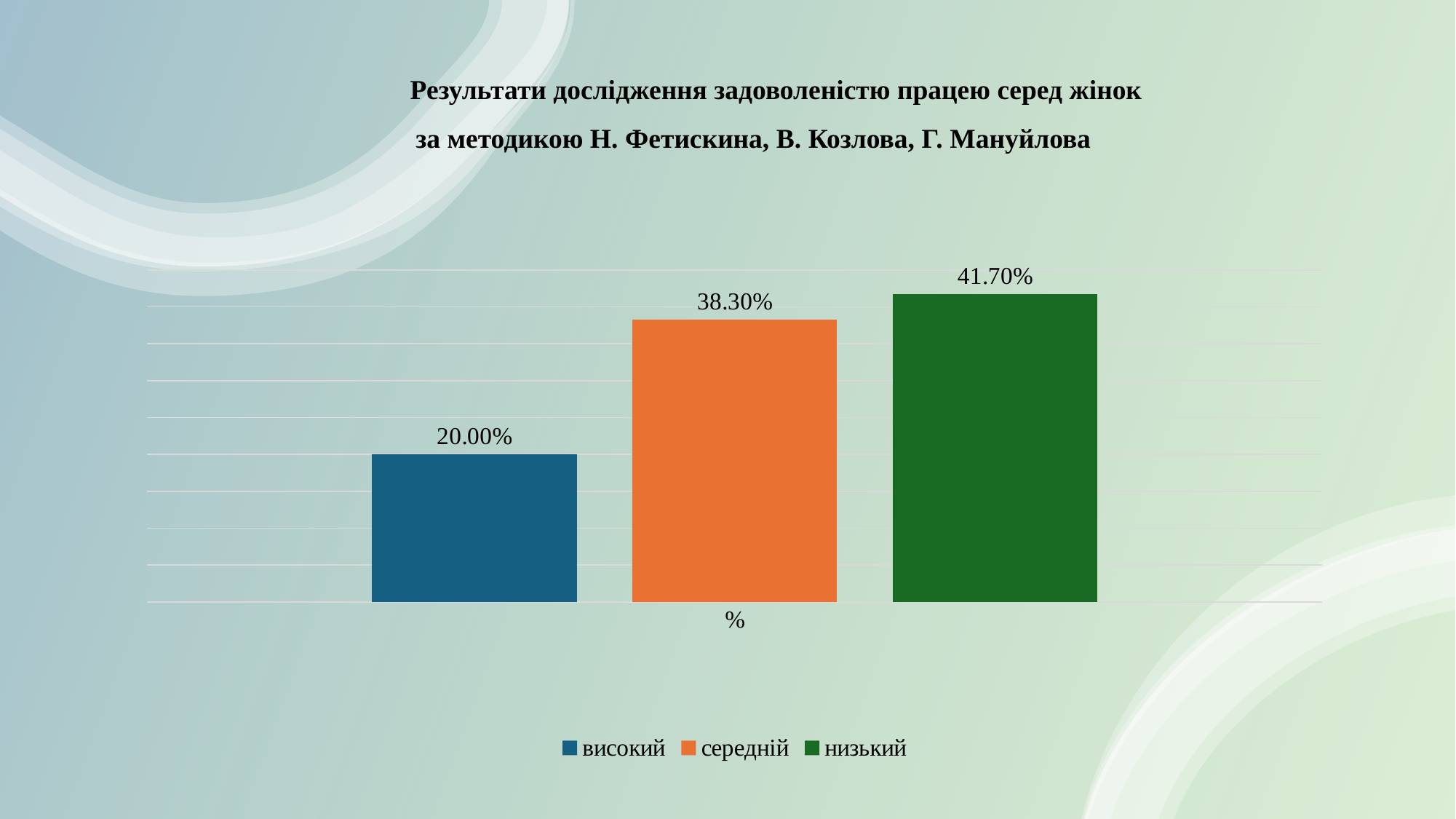
What is the difference between the values for низький and високий? 21.70% Which series has the highest value? низький How many series does the legend list? 3 What is the value for високий? 20.00% What is the difference between the values for середній and високий? 18.30% What colour is the bar for середній? orange Which is larger, the value for середній or the value for високий? середній How many bars are plotted in the chart? 3 What type of chart is shown on the slide? bar chart What is the value for середній? 38.30% Which series has the lowest value? високий What is the value for низький? 41.70%